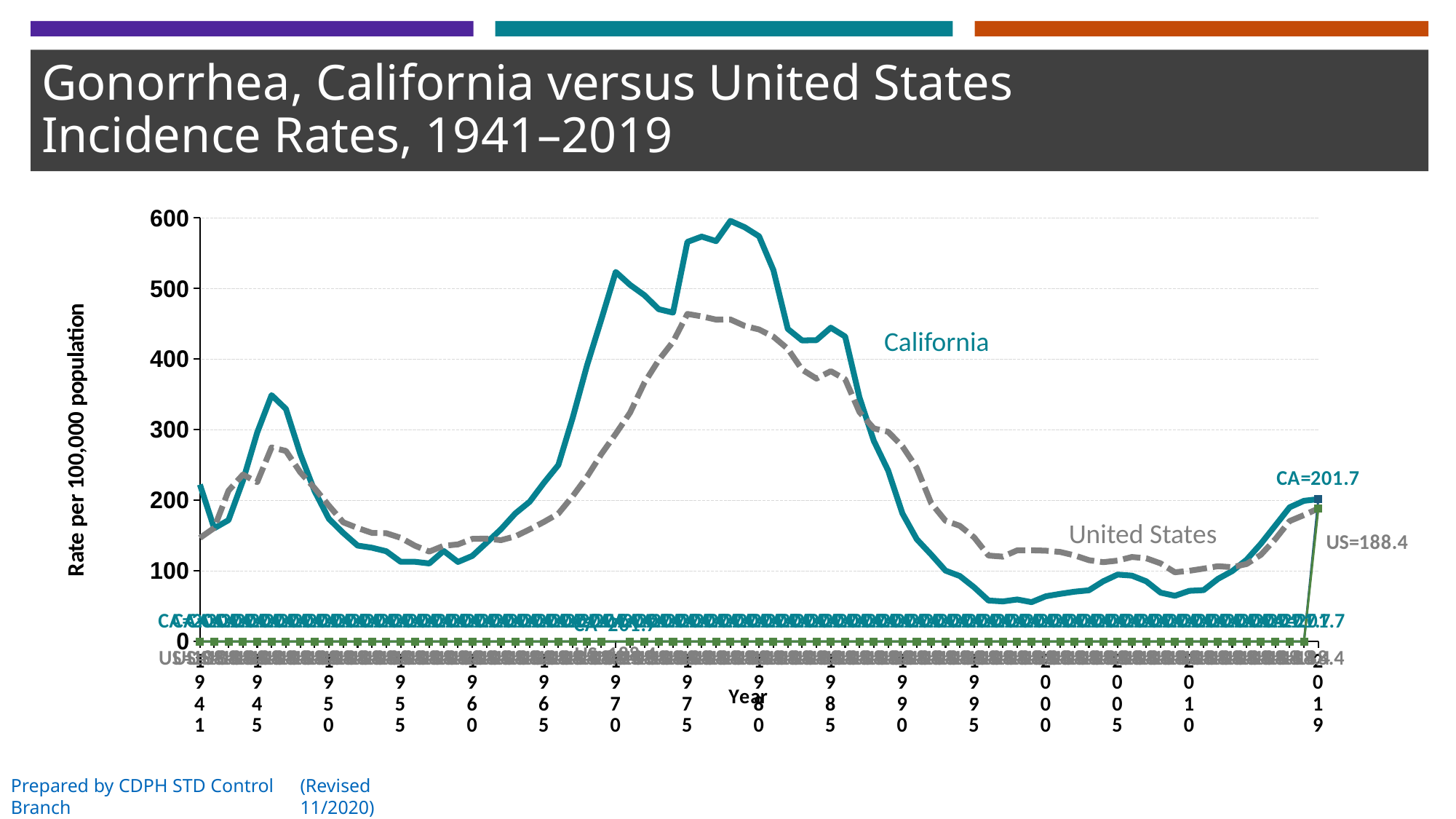
Is the United States rate in 1975 greater or less than 400? greater How many series are plotted on the chart? 4 What kind of chart is shown on the slide? Line chart In 2019, which has the higher rate, California or the United States? California Does the California rate rise or fall between 1980 and 1995? Fall Is the California rate in 1975 greater or less than 500? greater What is the difference between the California and United States rates in 2019? 13.3 Is the California rate in 1995 greater or less than 100? less Which series reaches the highest peak on the chart? California What is the United States gonorrhea incidence rate shown for 2019? 188.4 What is the California gonorrhea incidence rate shown for 2019? 201.7 What is the label on the vertical axis? Rate per 100,000 population